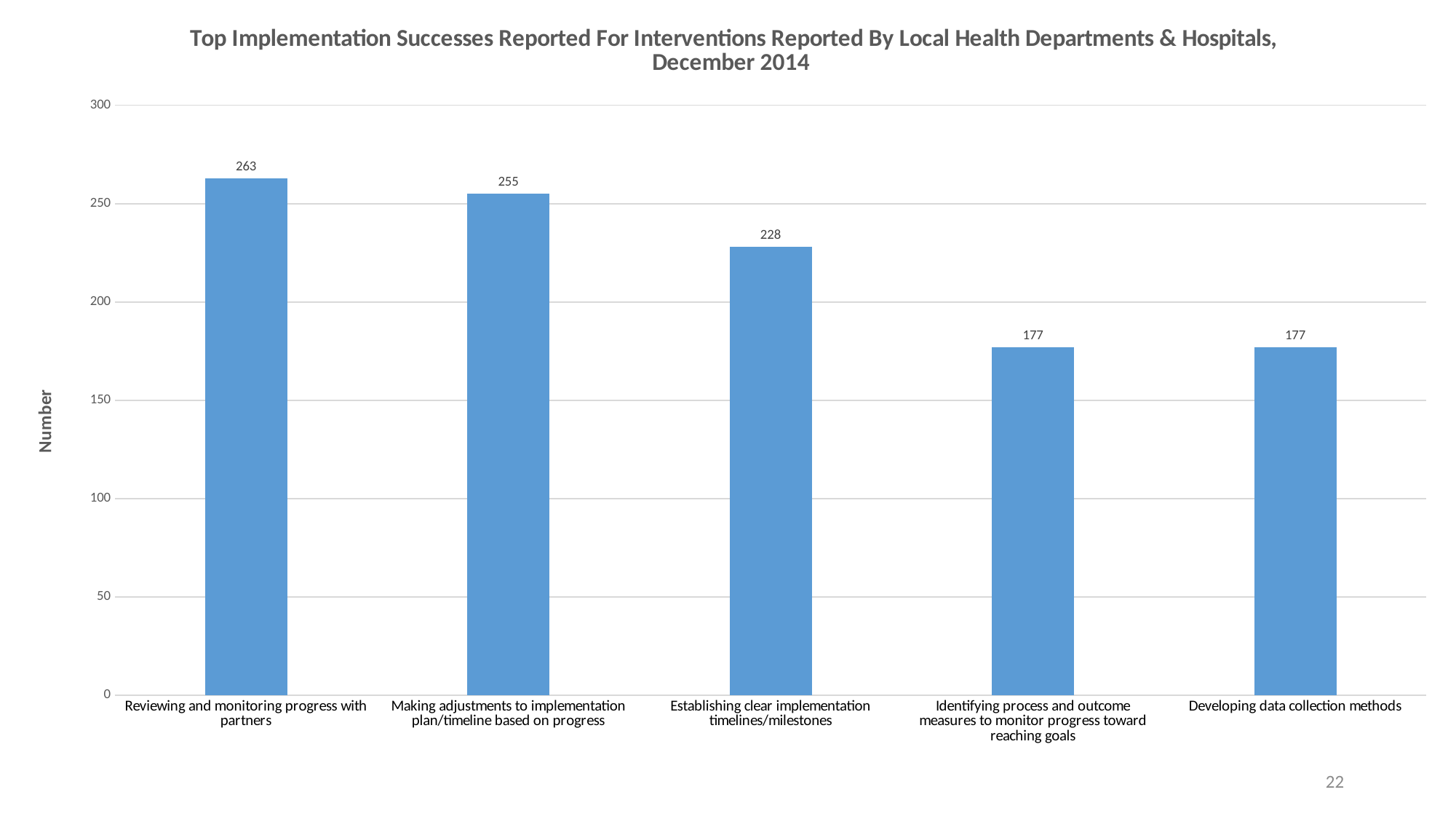
What is the value for "Establishing clear implementation timelines/milestones"? 228 Which is larger, the value for "Establishing clear implementation timelines/milestones" or the value for "Developing data collection methods"? Establishing clear implementation timelines/milestones What is the value for "Developing data collection methods"? 177 Is the value for "Identifying process and outcome measures to monitor progress toward reaching goals" greater or less than 200? less Do the values rise or fall from left to right across the categories? Fall What is the difference between the values for "Reviewing and monitoring progress with partners" and "Making adjustments to implementation plan/timeline based on progress"? 8 Which category has the highest value? Reviewing and monitoring progress with partners How many categories are shown on the chart? 5 What is the value for "Reviewing and monitoring progress with partners"? 263 What kind of chart is shown on the slide? Bar chart What is the label of the vertical axis? Number What is the difference between the values for "Making adjustments to implementation plan/timeline based on progress" and "Establishing clear implementation timelines/milestones"? 27